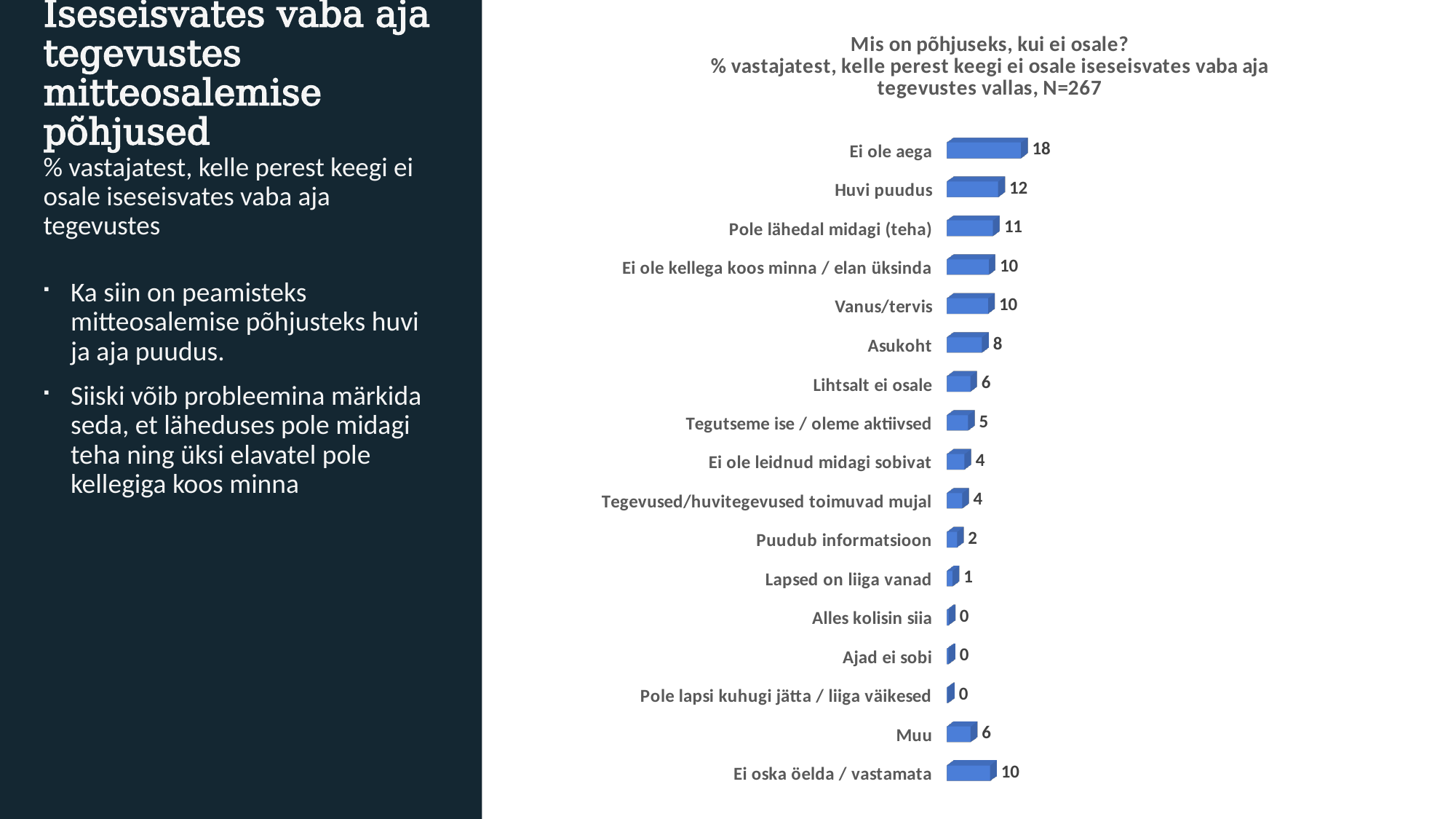
What is the N stated in the chart title? 267 How many categories are shown in the chart? 17 What is the value for "Ei ole aega"? 18 What is the value for "Huvi puudus"? 12 What is the lowest value shown in the chart? 0 Which category has the highest value? Ei ole aega What is the value for "Asukoht"? 8 Which is larger, the value for "Lihtsalt ei osale" or the value for "Tegutseme ise / oleme aktiivsed"? Lihtsalt ei osale What kind of chart is shown on the slide? bar chart What is the difference between the values for "Pole lähedal midagi (teha)" and "Puudub informatsioon"? 9 What is the value for "Ei oska öelda / vastamata"? 10 What is the difference between the values for "Ei ole aega" and "Huvi puudus"? 6